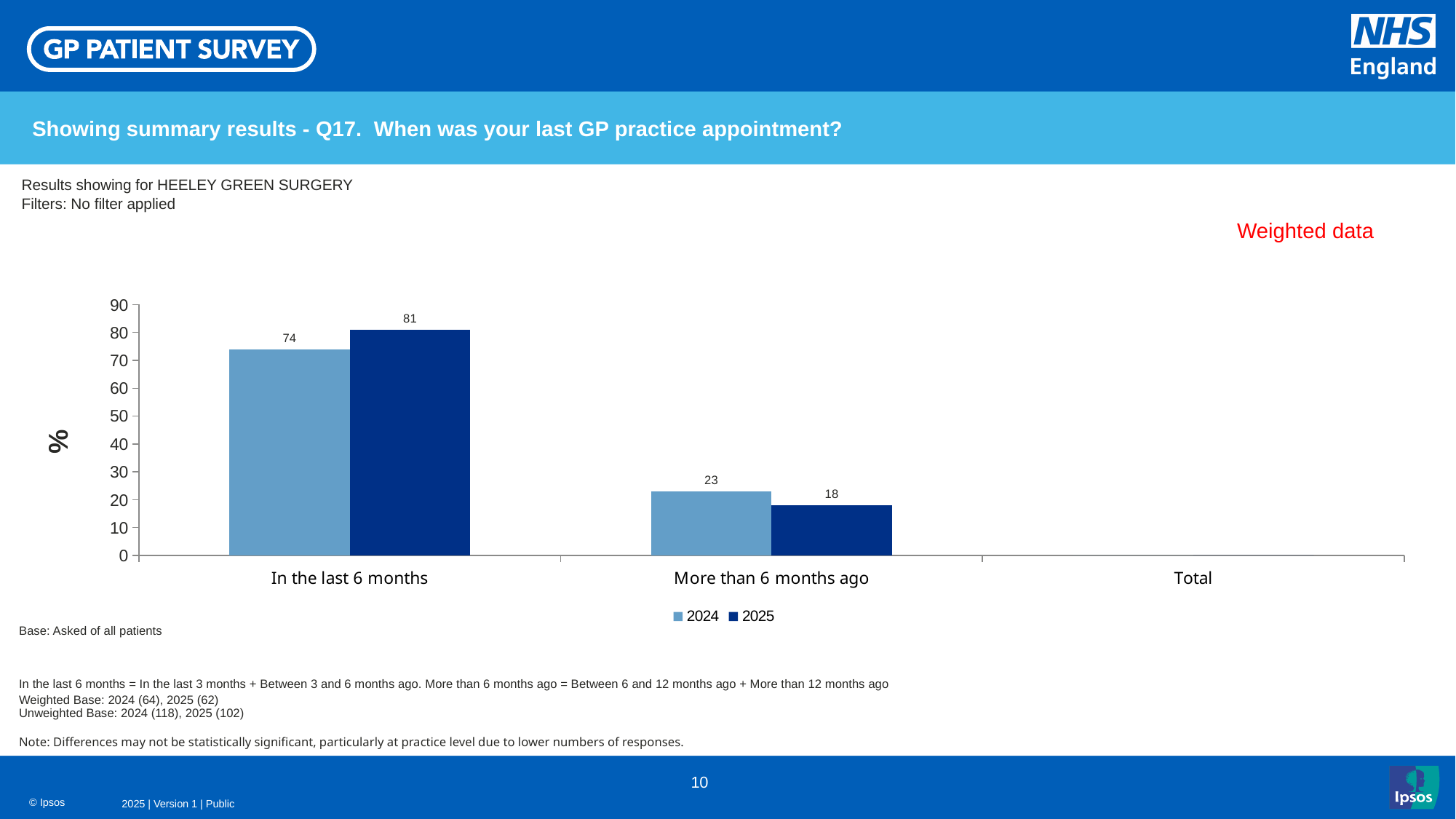
Which bar has the highest value on the chart? 2025, In the last 6 months What is the value for 2024 in the 'In the last 6 months' category? 74 What is the difference between the 2025 and 2024 values for 'In the last 6 months'? 7 What is the value for 2025 in the 'More than 6 months ago' category? 18 What is the difference between the 2024 and 2025 values for 'More than 6 months ago'? 5 Which series has the higher value for 'In the last 6 months', 2024 or 2025? 2025 What is the value for 2025 in the 'In the last 6 months' category? 81 What kind of chart is shown on the slide? Bar chart Which bar has the lowest value on the chart? 2025, More than 6 months ago How many series does the legend list? 2 What is the value for 2024 in the 'More than 6 months ago' category? 23 Which series has the higher value for 'More than 6 months ago', 2024 or 2025? 2024